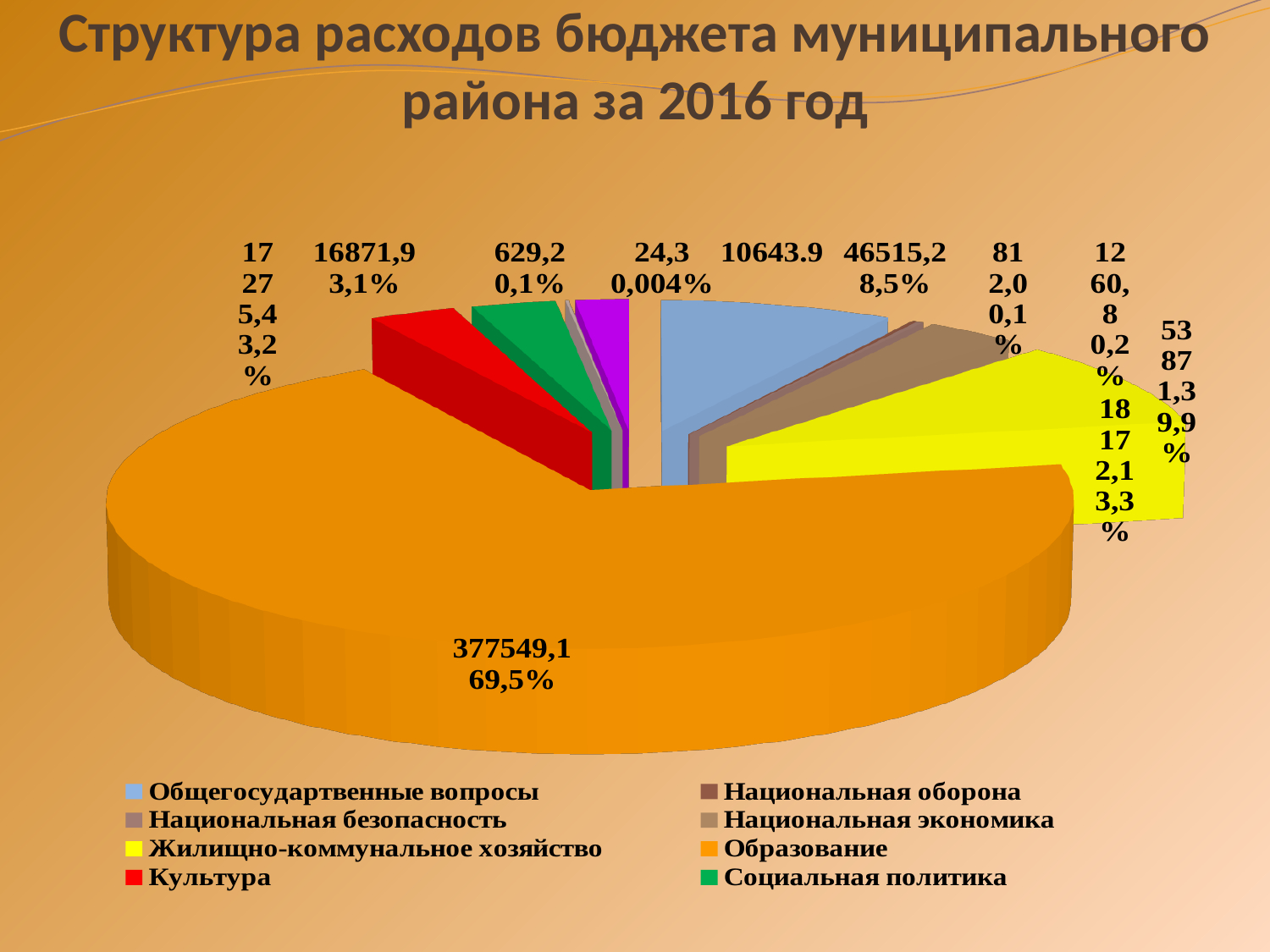
What share of the pie does Образование account for? 69,5% What kind of chart is shown on the slide? pie chart How many entries does the legend list? 8 Which category has the largest slice of the pie? Образование What is the title of the chart? Структура расходов бюджета муниципального района за 2016 год Which is larger, the slice for Образование or the slice for Культура? Образование What value is printed on the Образование slice? 377549,1 Which is larger, the slice for Образование or the slice for Жилищно-коммунальное хозяйство? Образование Is the share for Образование greater or less than 50%? greater Which colour represents Образование in the legend? orange